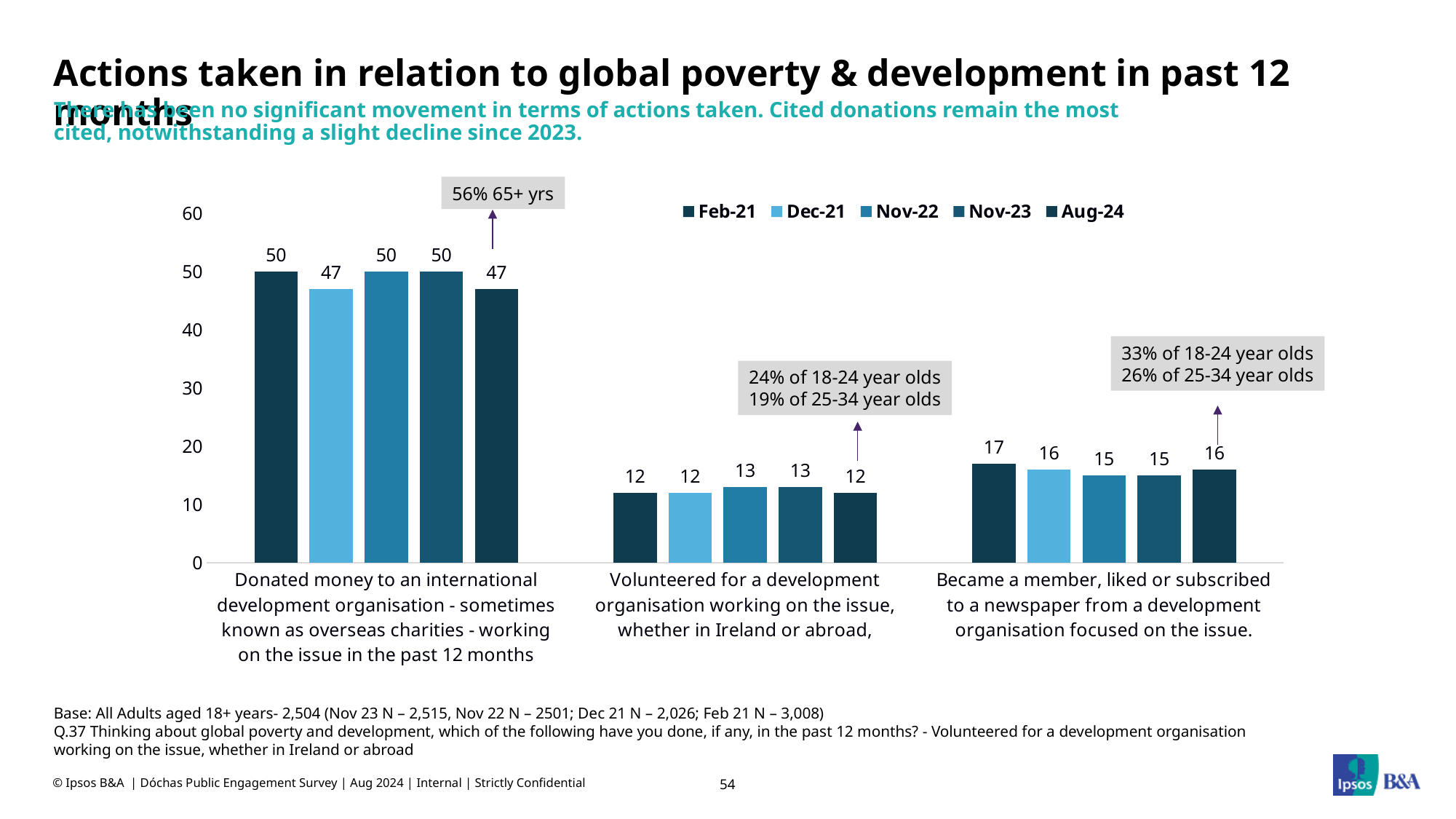
According to the callout above the 'Donated money' bars, what percentage of those aged 65+ donated money? 56% What is the Feb-21 value for 'Became a member, liked or subscribed to a newspaper from a development organisation focused on the issue'? 17 What is the Nov-22 value for 'Volunteered for a development organisation working on the issue, whether in Ireland or abroad'? 13 How many categories are shown on the x axis? 3 What is the difference between the Feb-21 and Aug-24 values for 'Donated money to an international development organisation'? 3 How many series does the legend list? 5 Is the Nov-23 value for 'Donated money to an international development organisation' greater or less than 40? greater What is the Aug-24 value for 'Donated money to an international development organisation'? 47 Which category has the lowest values across all survey waves? Volunteered for a development organisation working on the issue Which is larger for 'Became a member, liked or subscribed to a newspaper': the Feb-21 value or the Nov-23 value? Feb-21 What kind of chart is shown on the slide? Bar chart Which category has the highest values across all survey waves? Donated money to an international development organisation